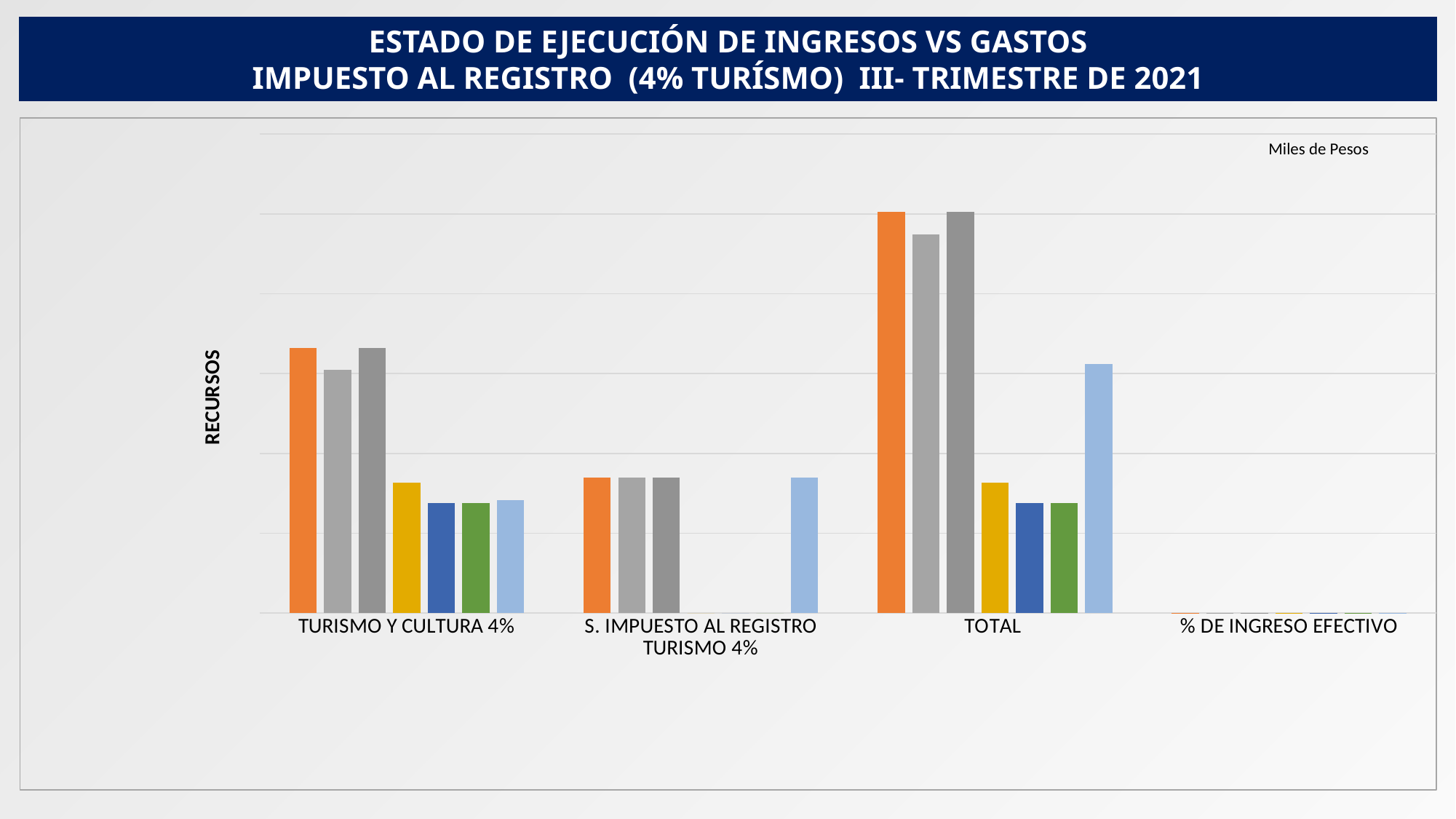
Which category has the smallest bars in the chart? % DE INGRESO EFECTIVO What is the label on the vertical axis of the chart? RECURSOS What kind of chart is shown on the slide? Bar chart How many categories are shown along the x axis of the chart? 4 In the TURISMO Y CULTURA 4% group, is the orange bar or the yellow bar larger? Orange In the TOTAL group, is the light blue bar or the yellow bar larger? Light blue Is the orange bar larger for TOTAL or for TURISMO Y CULTURA 4%? TOTAL How many bars are visible in the TOTAL group? 7 How many bars are visible in the S. IMPUESTO AL REGISTRO TURISMO 4% group? 4 Which category has the tallest bars in the chart? TOTAL What unit note is shown in the top right corner of the chart area? Miles de Pesos